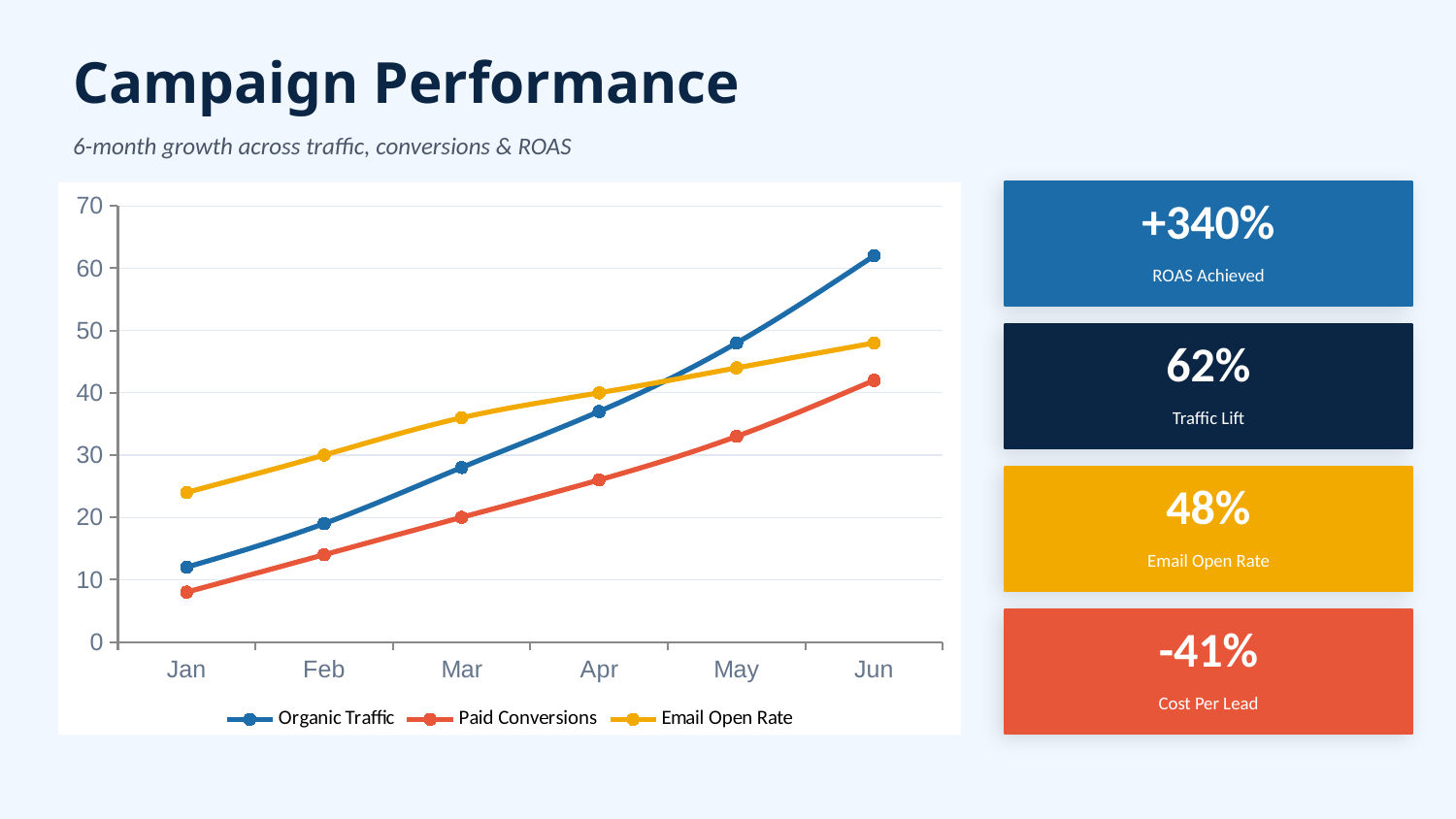
Which colour is used for the Paid Conversions series in the chart? red Which series has the lowest value in Jan? Paid Conversions Is the value for Organic Traffic in Apr greater or less than 40? less Is the value for Email Open Rate in Jan greater or less than 20? greater Is the value for Organic Traffic in Jun greater or less than 50? greater What kind of chart is shown on the slide? line chart Which series has the highest value in Jun? Organic Traffic How many series does the chart legend list? 3 Does the Organic Traffic series rise or fall from Jan to Jun? rise In Jan, which is larger: Email Open Rate or Organic Traffic? Email Open Rate How many months are plotted along the x axis of the chart? 6